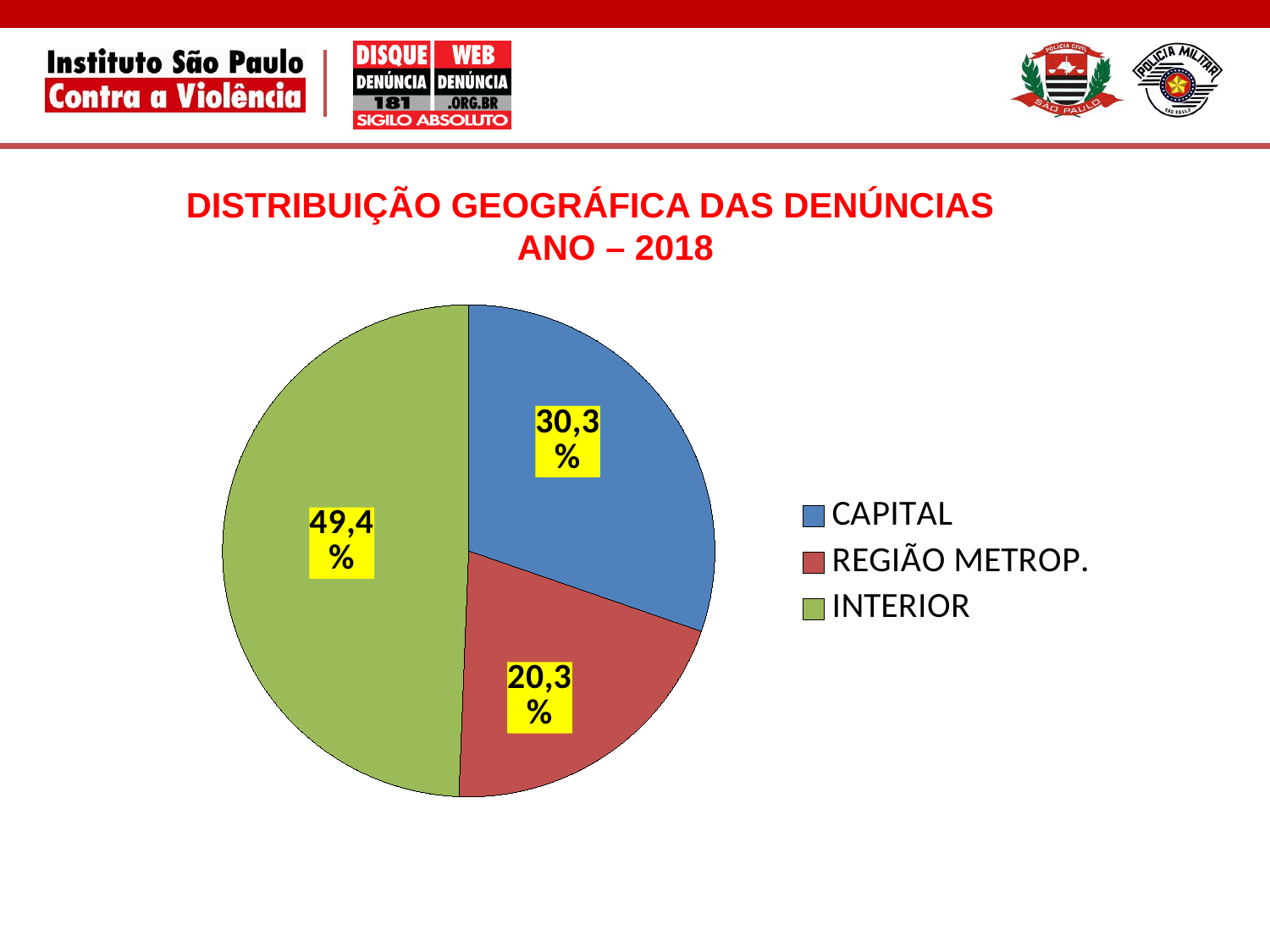
What is the title of the chart? DISTRIBUIÇÃO GEOGRÁFICA DAS DENÚNCIAS ANO – 2018 What is the difference in percentage points between CAPITAL and REGIÃO METROP.? 10 Which category has the smallest share of the pie? REGIÃO METROP. What share of the pie does CAPITAL represent? 30,3% Which category has the largest share of the pie? INTERIOR What colour is the slice for INTERIOR? Green How many slices does the pie chart have? 3 What kind of chart is shown on the slide? Pie chart Which is larger, the share for CAPITAL or the share for REGIÃO METROP.? CAPITAL What share of the pie does INTERIOR represent? 49,4% What share of the pie does REGIÃO METROP. represent? 20,3% What is the difference in percentage points between INTERIOR and CAPITAL? 19,1